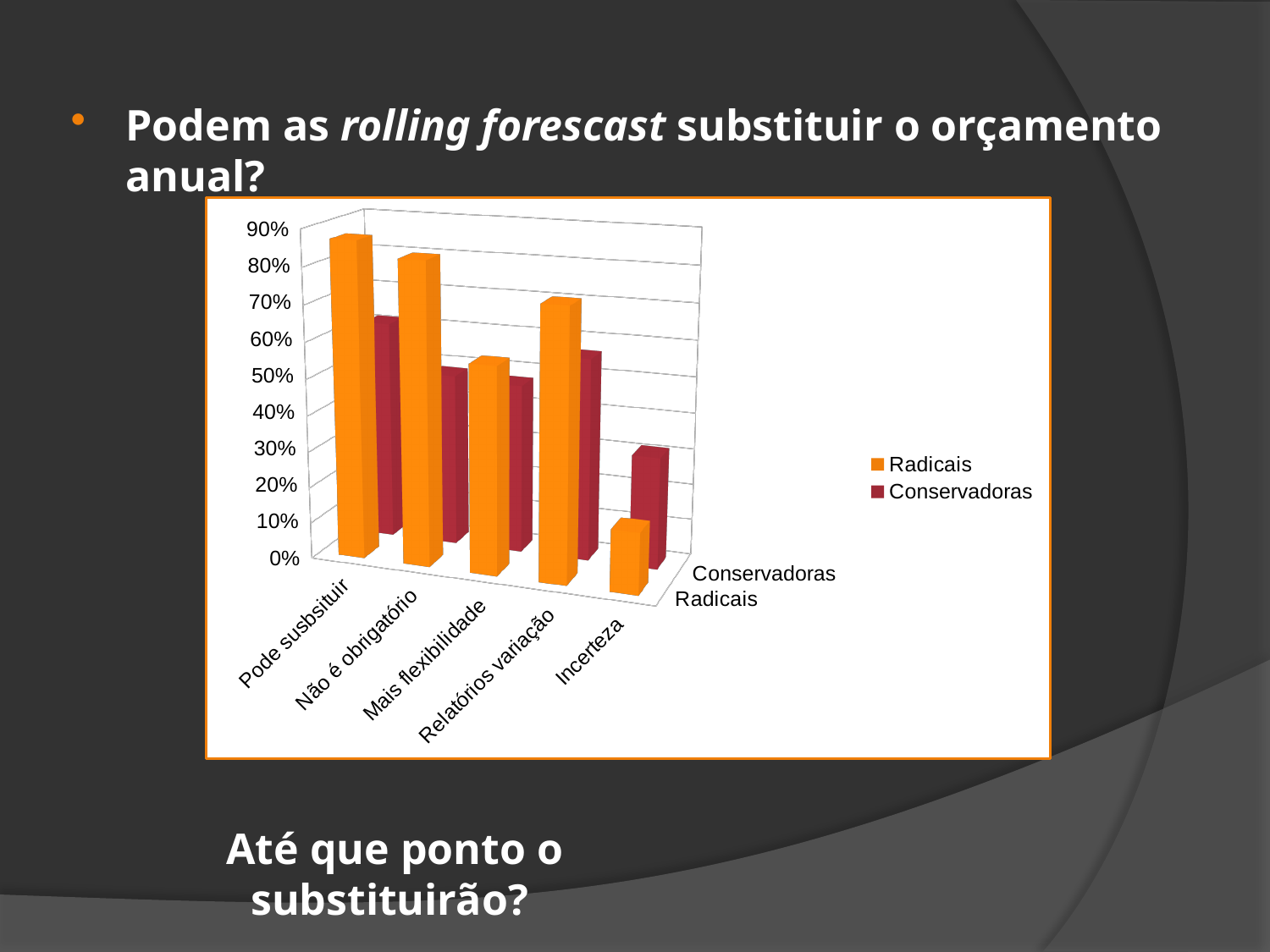
Is the Radicais value for Incerteza greater or less than 20%? less Is the Radicais value for Pode susbstituir greater or less than 70%? greater Which category has the lowest value for the Radicais series? Incerteza Which category has the lowest value for the Conservadoras series? Incerteza How many categories are shown along the x axis of the chart? 5 Which category has the highest value for the Radicais series? Pode susbsituir What colour are the bars for the Radicais series? orange For the Pode susbstituir category, which series has the larger value, Radicais or Conservadoras? Radicais For the Incerteza category, which series has the larger value, Radicais or Conservadoras? Conservadoras Which category has the highest value for the Conservadoras series? Pode susbsituir How many series does the chart legend list? 2 What kind of chart is shown on the slide? bar chart